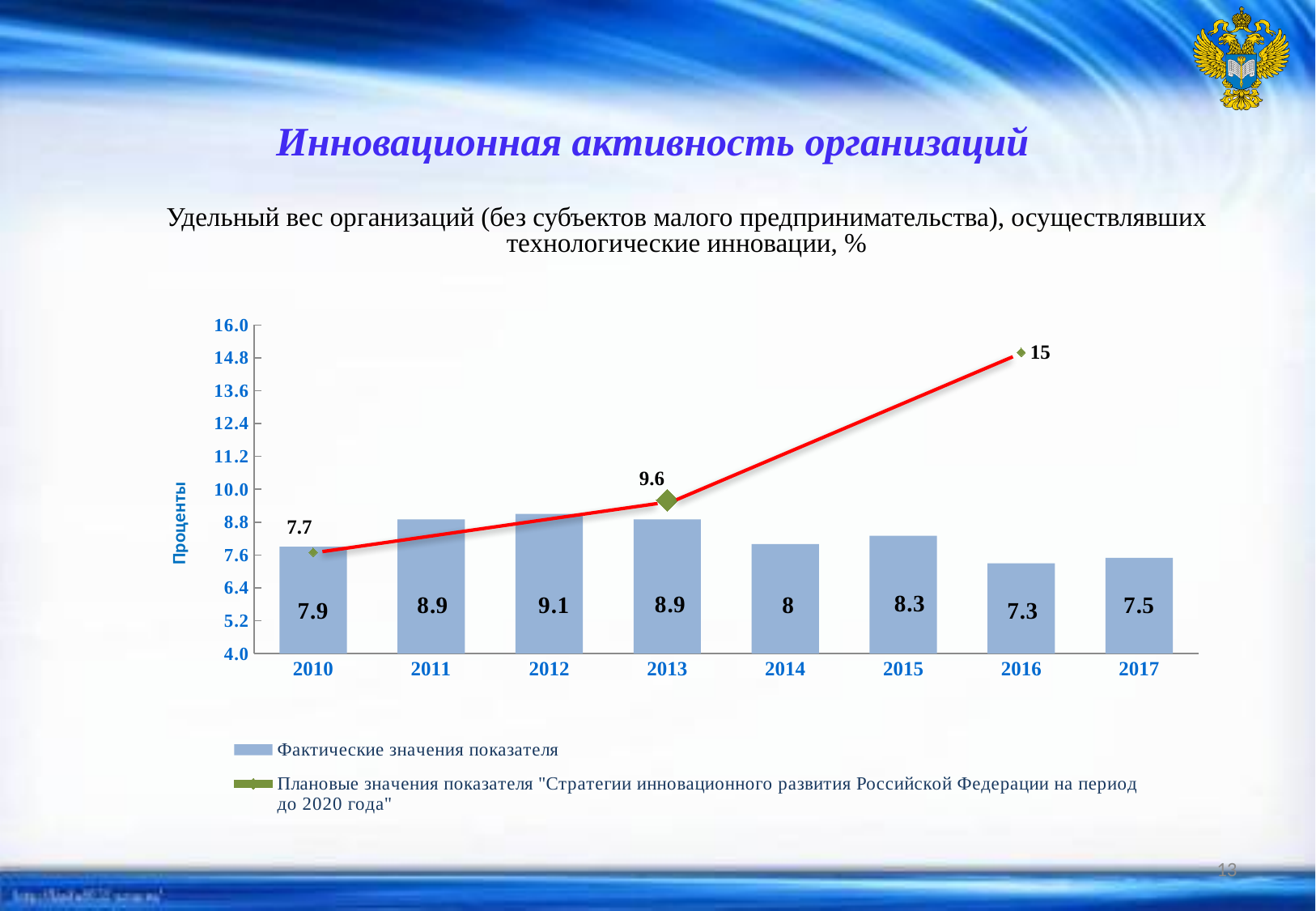
Do the actual values (bars) rise or fall from 2013 to 2016? fall What is the difference between the actual values for 2012 and 2017? 1.6 How many years are shown on the x axis? 8 What is the actual value (Фактические значения показателя) for 2012? 9.1 What is the planned value (Плановые значения показателя) for 2013? 9.6 What is the planned value (Плановые значения показателя) for 2016? 15 Which year has the lowest actual value among the bars? 2016 What is the actual value (Фактические значения показателя) for 2016? 7.3 How many series does the legend list? 2 What is the difference between the planned value and the actual value for 2016? 7.7 Which is larger: the actual value for 2014 or the actual value for 2015? 2015 Which year has the highest actual value among the bars? 2012